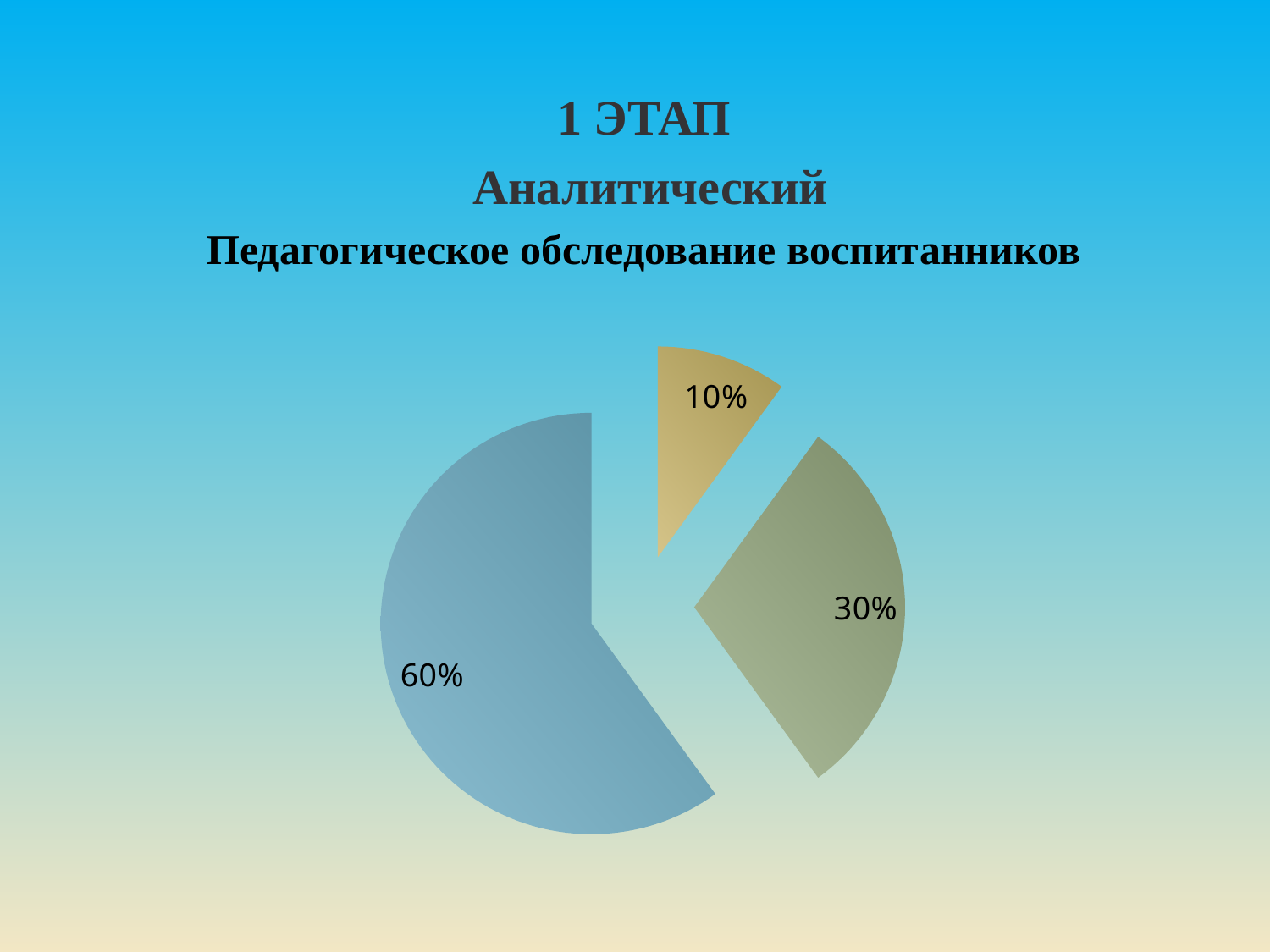
What is the largest value shown in the pie chart? 60% What is the difference between the largest and smallest slices of the pie chart? 50% What value is labelled on the olive-green slice of the pie chart? 30% What value is labelled on the blue slice of the pie chart? 60% What do the three slice values of the pie chart add up to? 100% What kind of chart is shown on the slide? pie chart How many slices does the pie chart have? 3 What is the smallest value shown in the pie chart? 10% Which slice is larger, the olive-green one or the gold one? the olive-green one What is the difference between the blue slice and the olive-green slice? 30% What value is labelled on the gold slice of the pie chart? 10%